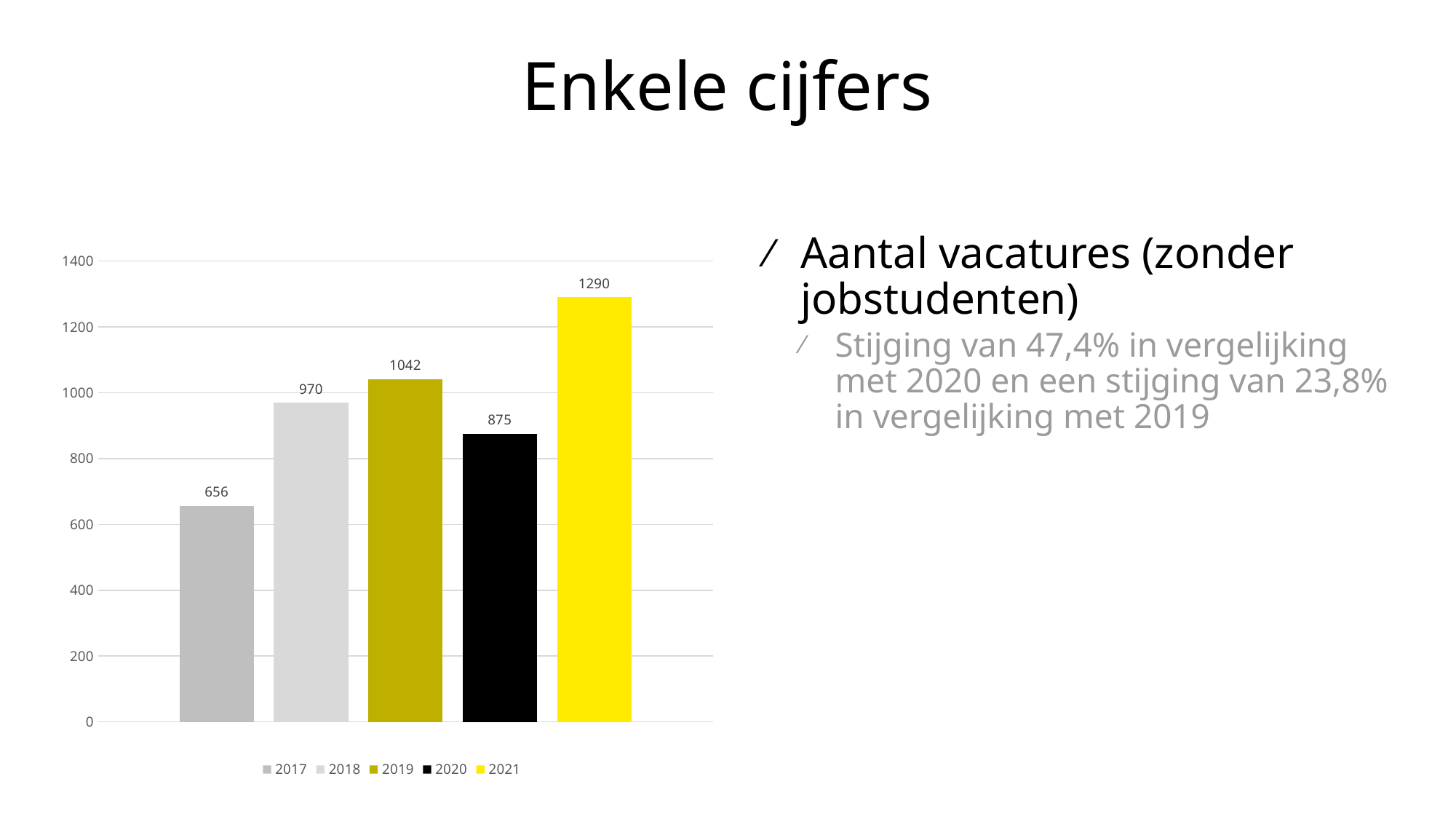
Which year has the lowest value? 2017 What is the value for 2021? 1290 How many bars are shown in the chart? 5 Which is larger, the value for 2019 or the value for 2020? 2019 Which year has the highest value? 2021 What is the value for 2017? 656 How many entries does the legend list? 5 Is the value for 2018 greater or less than 1000? less What is the difference between the values for 2019 and 2018? 72 What is the difference between the values for 2021 and 2020? 415 What kind of chart is shown on the slide? bar chart What is the value for 2020? 875